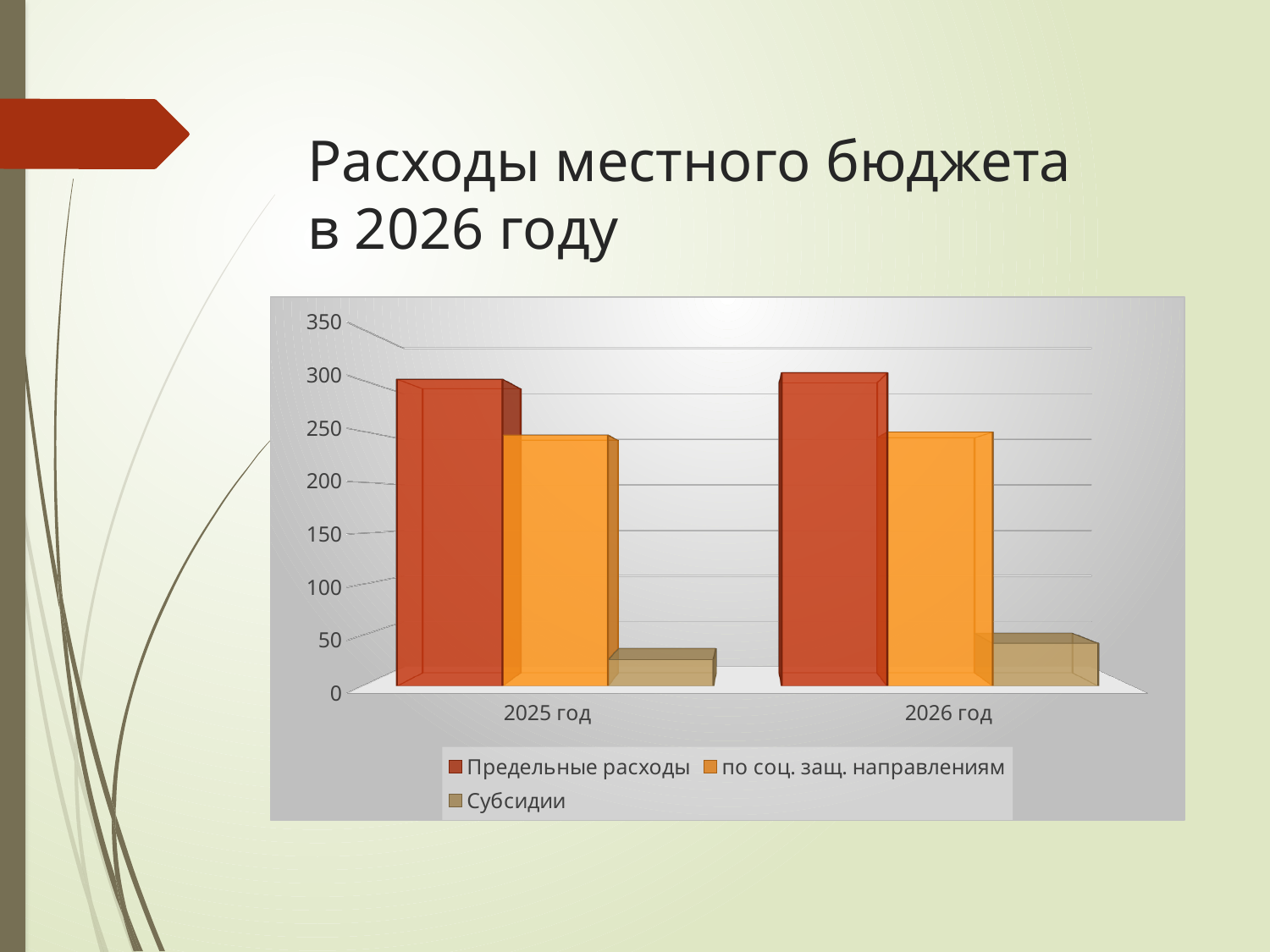
What kind of chart is shown on the slide? bar chart How many categories are shown on the x axis? 2 Is the value of по соц. защ. направлениям for 2025 год greater or less than 300? less Which series has the lowest value for 2026 год? Субсидии Which series has the highest value for 2025 год? Предельные расходы For 2026 год, which is larger: Предельные расходы or Субсидии? Предельные расходы How many series does the legend list? 3 Which series is shown in dark red in the legend? Предельные расходы Is the value of по соц. защ. направлениям for 2026 год greater or less than 200? greater Is the value of Предельные расходы for 2025 год greater or less than 250? greater What is the title of the slide containing the chart? Расходы местного бюджета в 2026 году